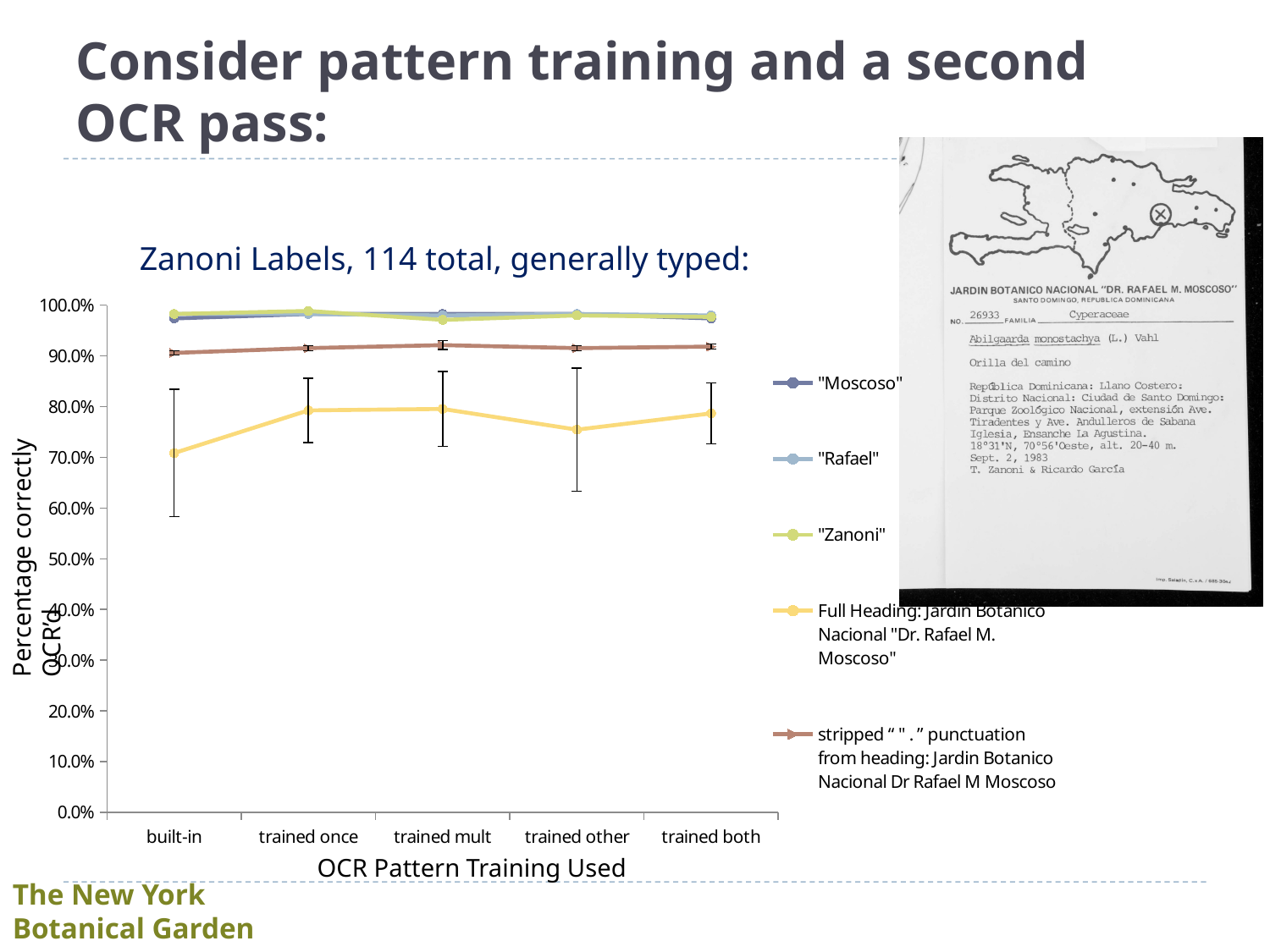
How many series does the chart's legend list? 5 What is the title of the chart? Zanoni Labels, 114 total, generally typed: Which series has the lowest values across the chart? Full Heading: Jardin Botanico Nacional "Dr. Rafael M. Moscoso" At built-in, which is larger: the Full Heading series or the stripped punctuation series? stripped punctuation series Is the value for the Full Heading series at built-in greater or less than 80.0%? less What kind of chart is shown on the slide? line chart Is the value for the Full Heading series at trained other greater or less than 70.0%? greater What is the x-axis label of the chart? OCR Pattern Training Used How many categories are shown on the x axis of the chart? 5 Does the Full Heading series rise or fall from built-in to trained once? rise Is the value for the stripped punctuation series at trained once greater or less than 80.0%? greater